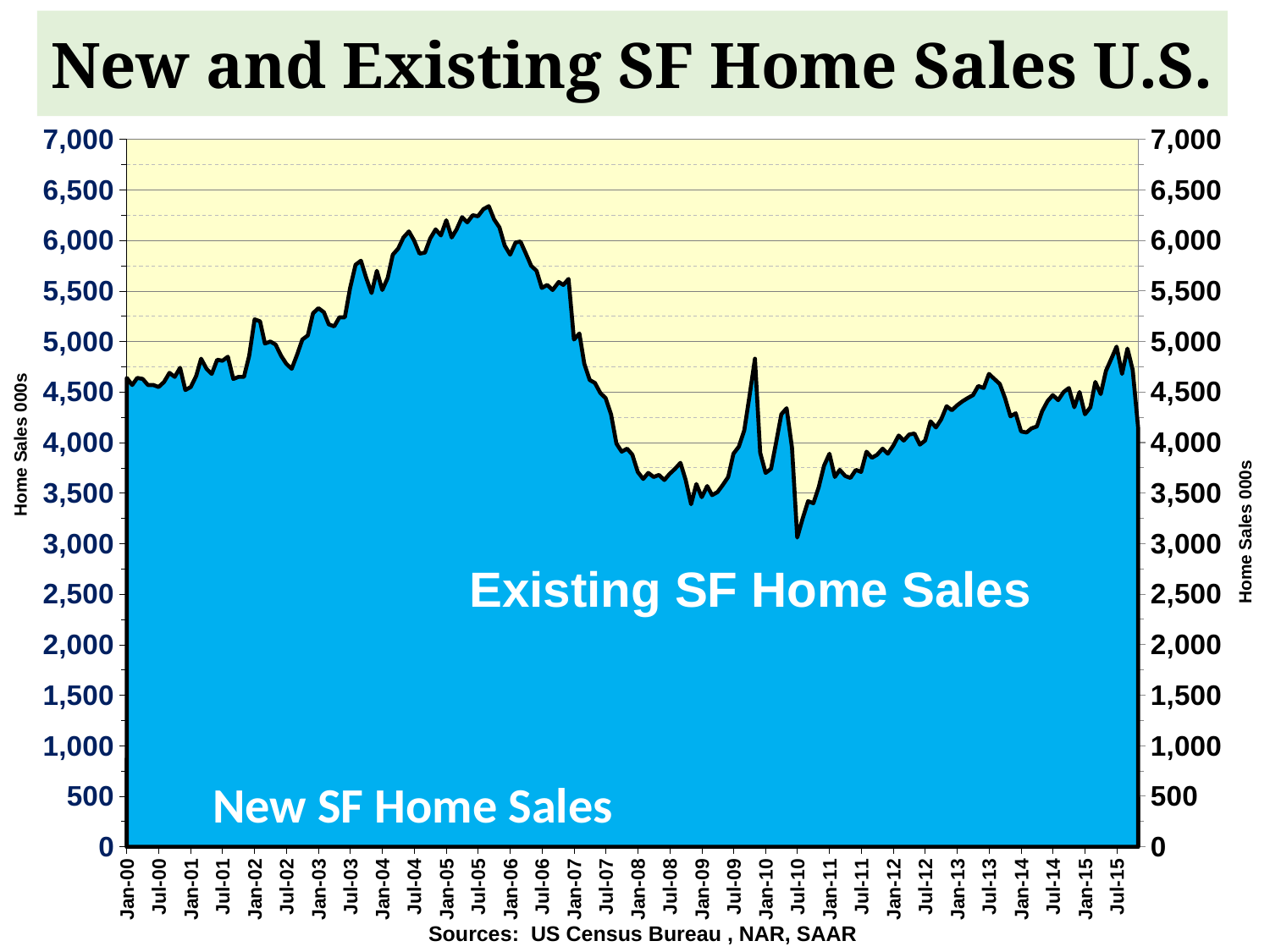
In which year does the chart reach its highest value? 2005 What label is shown on the vertical axis of the chart? Home Sales 000s Which is larger, the value at Jan-04 or the value at Jan-12? Jan-04 What kind of chart is shown on the slide? Area chart Is the value at Jan-08 greater or less than 4,000? less Is the value at Jan-13 greater or less than 4,000? greater What is the title of the chart? New and Existing SF Home Sales U.S. Is the value at Jul-10 greater or less than 3,500? less Do the values rise or fall between Jan-06 and Jan-08? fall Around which x-axis label does the chart reach its lowest value? Jul-10